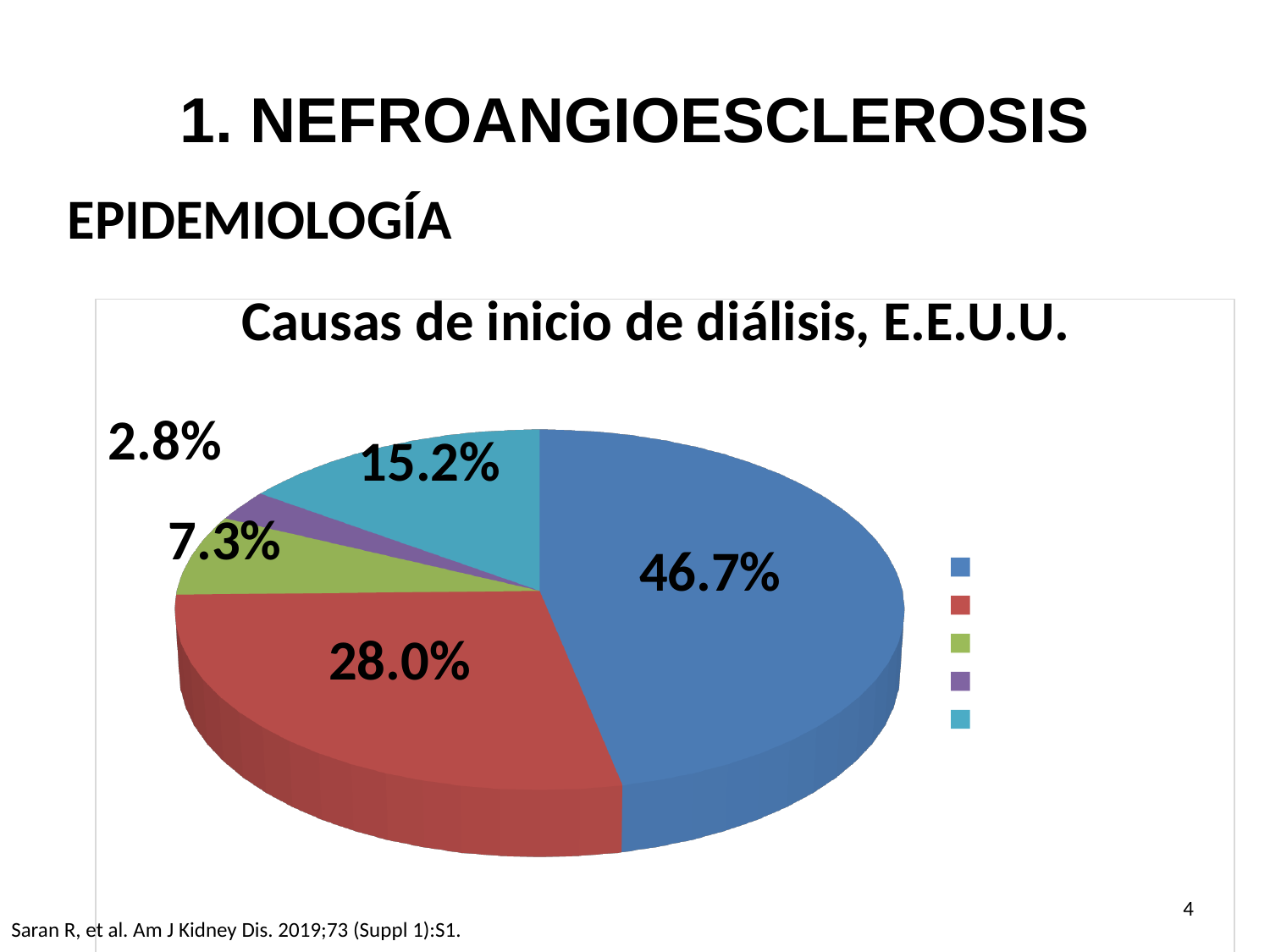
What kind of chart is shown on the slide? pie chart What percentage is shown on the red slice of the pie chart? 28.0% What is the difference between the blue slice (46.7%) and the red slice (28.0%)? 18.7% How many slices does the pie chart have? 5 What is the largest percentage shown on the pie chart? 46.7% What is the title of the chart? Causas de inicio de diálisis, E.E.U.U. Which slice is larger, the green slice or the teal slice? the teal slice What is the smallest percentage shown on the pie chart? 2.8% What percentage is shown on the light blue (teal) slice of the pie chart? 15.2% What colour is the largest slice of the pie chart? blue What percentage is shown on the blue slice of the pie chart? 46.7% What percentage is shown on the green slice of the pie chart? 7.3%